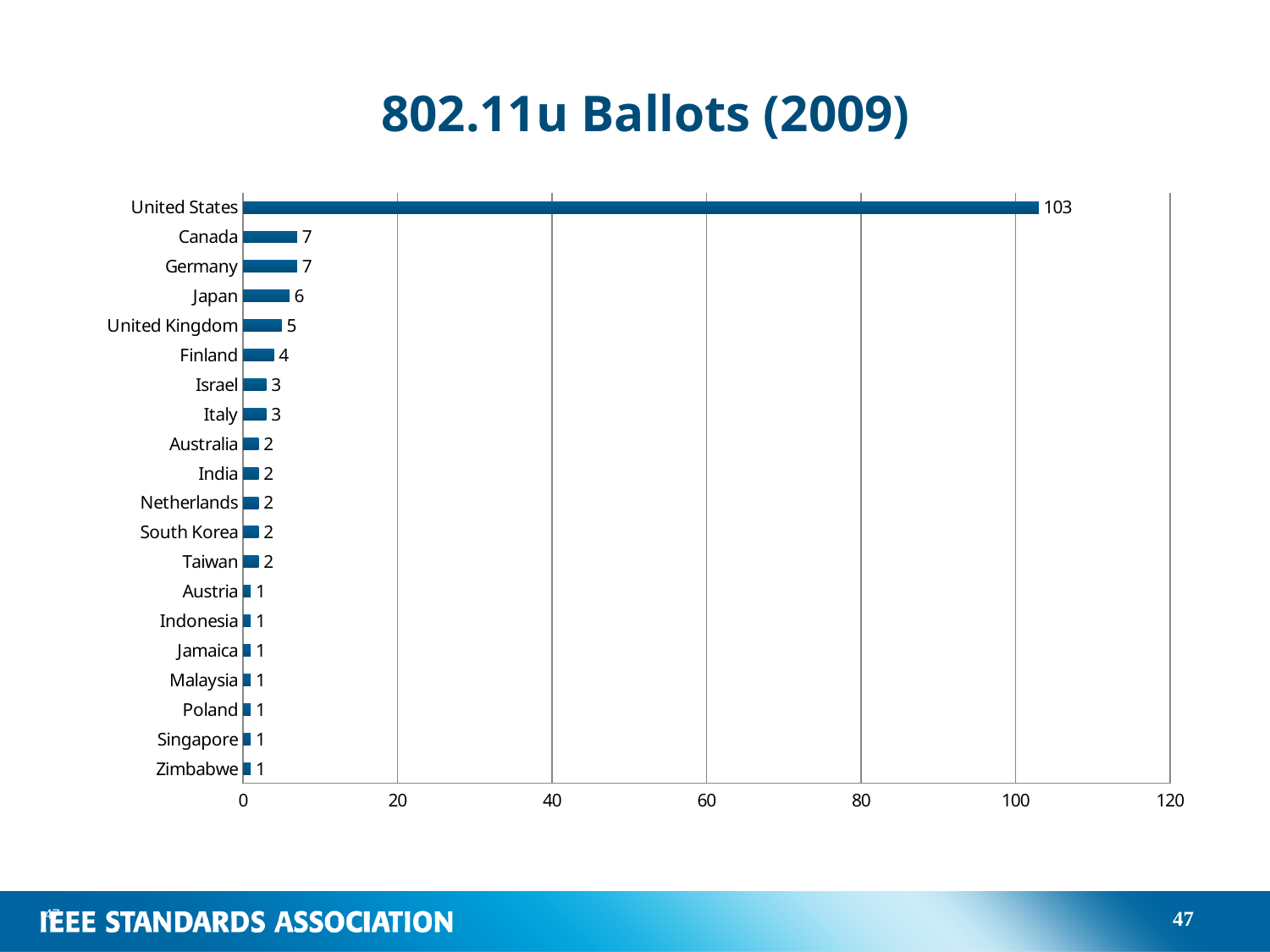
What is the value for the United States? 103 Is the value for the United States greater or less than 100? greater What is the value for Taiwan? 2 What is the title of the chart? 802.11u Ballots (2009) What is the difference between the values for the United States and Canada? 96 What kind of chart is shown on the slide? bar chart Which has a larger value, Japan or Finland? Japan What is the value for Japan? 6 What is the value for the United Kingdom? 5 How many countries are shown in the chart? 20 Which country has the highest value? United States What is the difference between the values for Finland and Israel? 1